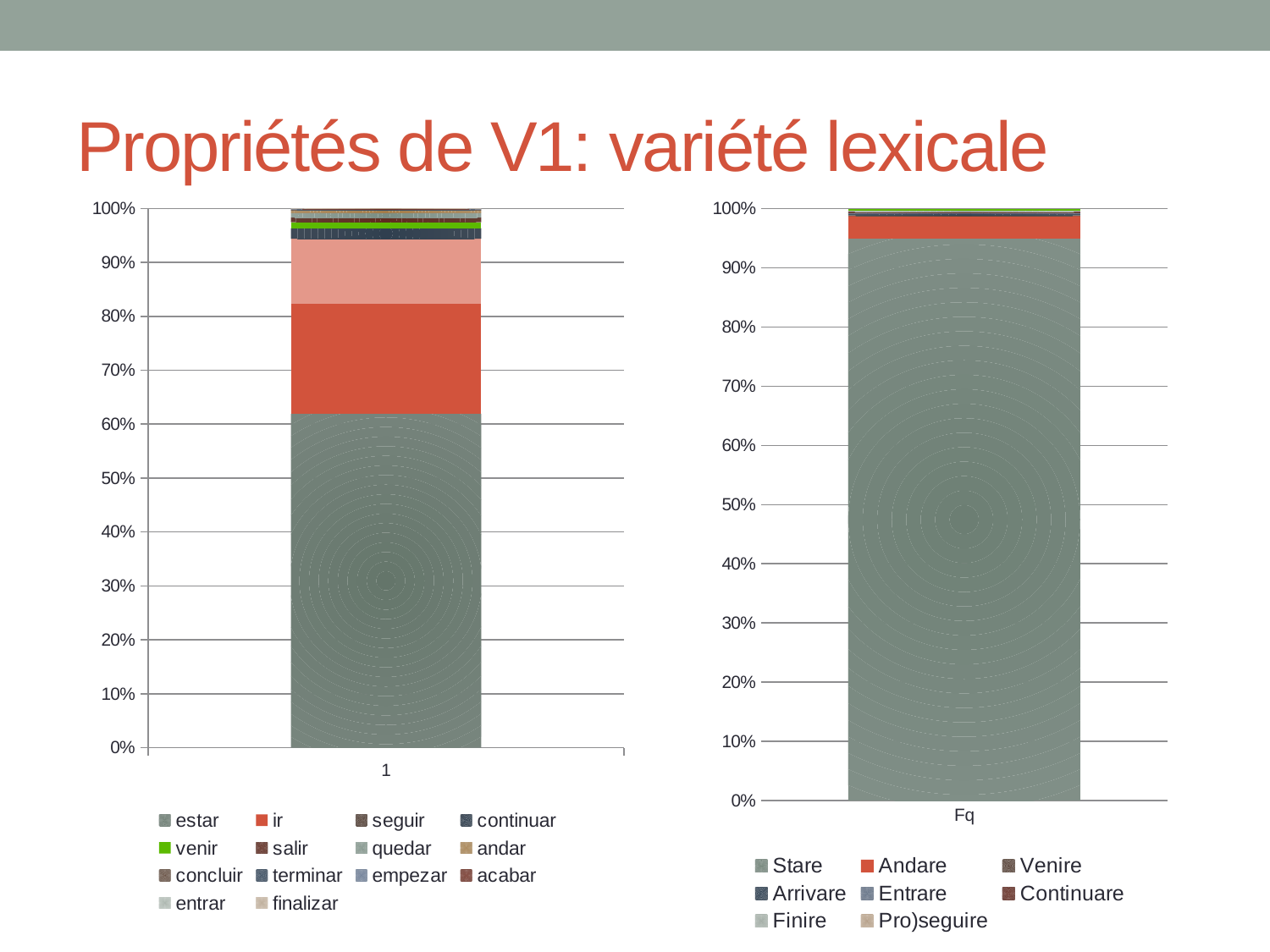
What is the title of the slide containing the two charts? Propriétés de V1: variété lexicale What is the category label on the x axis of the right chart? Fq In the right chart, which series takes up the largest share of the bar? Stare What kind of chart is the left chart on the slide? stacked bar chart How many series does the legend of the right chart list? 8 How many bars does the right chart show? 1 In the left chart, which series takes up the largest share of the bar? estar In the right chart, which is larger, the share for Stare or the share for Andare? Stare In the right chart, is the share for Stare greater or less than 90%? greater How many series does the legend of the left chart list? 14 In the left chart, is the share for estar greater or less than 50%? greater In the left chart, which is larger, the share for estar or the share for ir? estar